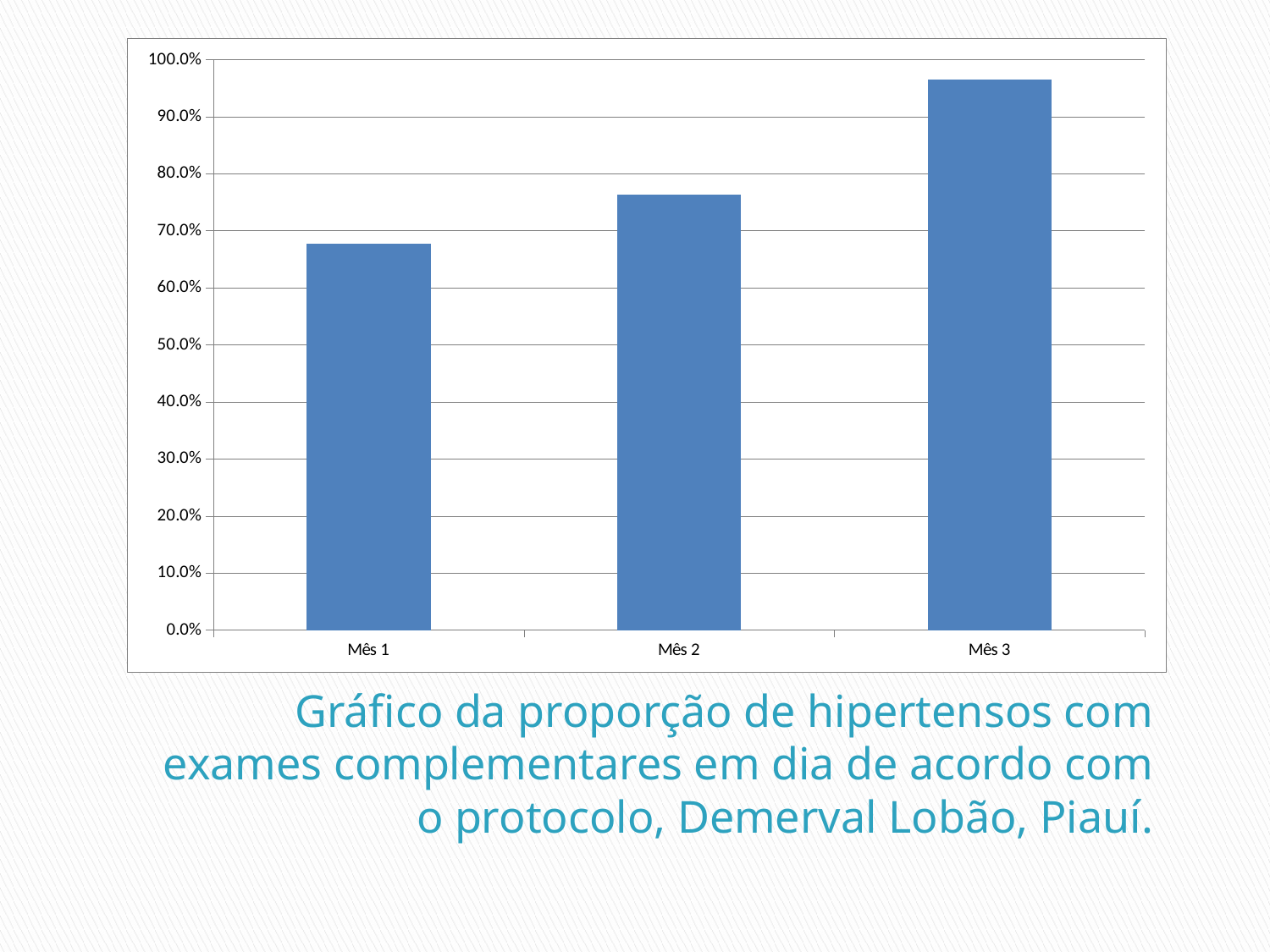
Which month has the lowest value? Mês 1 Which month has the highest value? Mês 3 Is the value for Mês 3 greater or less than 90.0%? greater What is the maximum value shown on the y axis? 100.0% Is the value for Mês 2 greater or less than 80.0%? less What kind of chart is shown on the slide? bar chart What colour are the bars in the chart? blue Do the values rise or fall from Mês 1 to Mês 3? rise Is the value for Mês 1 greater or less than 70.0%? less How many categories are plotted on the x axis? 3 Which is larger, the value for Mês 1 or the value for Mês 2? Mês 2